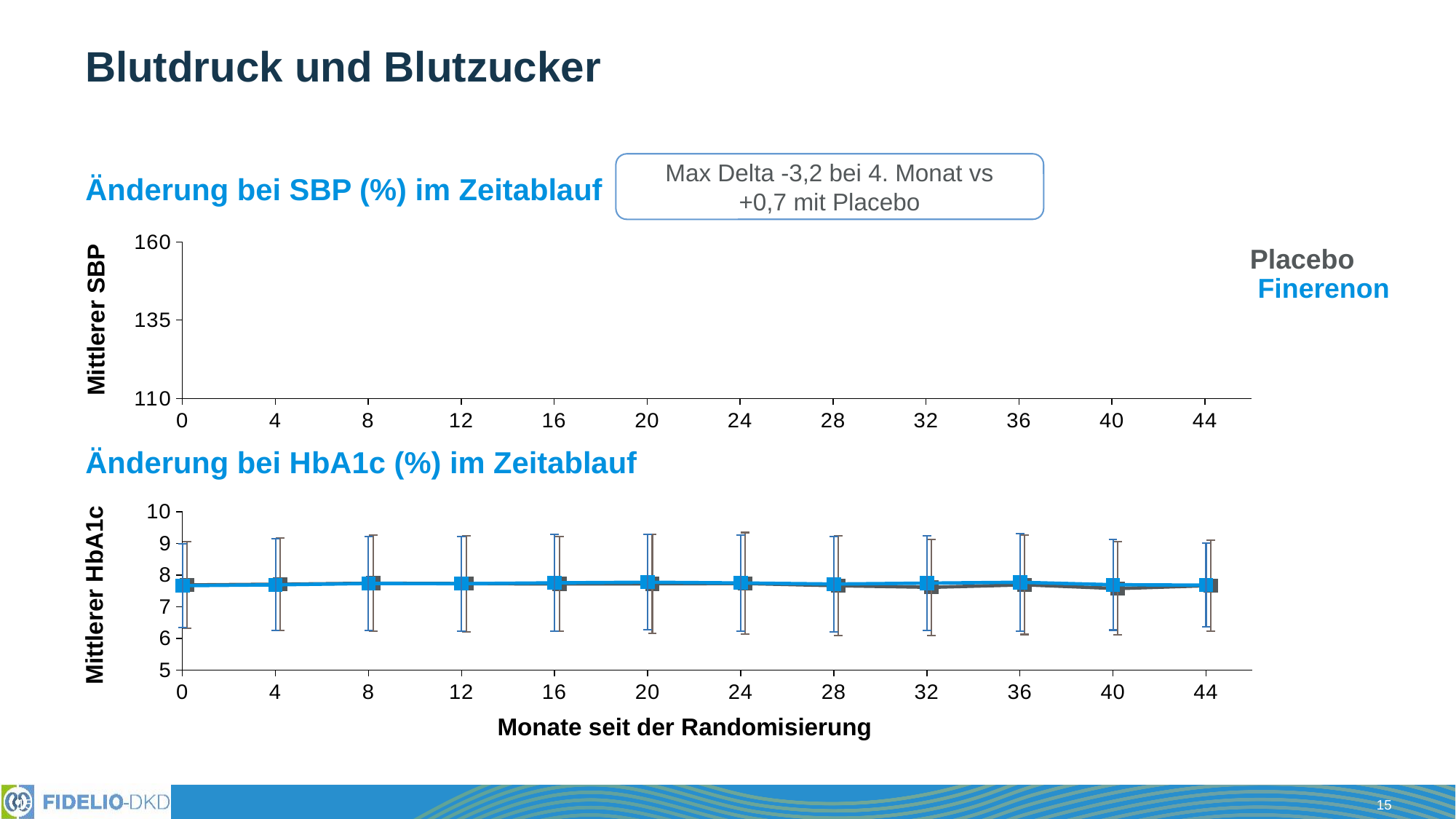
Which series in the HbA1c chart is drawn in blue? Finerenon In the 'Änderung bei HbA1c (%) im Zeitablauf' chart, do the Finerenon values rise, fall or stay roughly flat from month 0 to month 44? stay roughly flat In the HbA1c chart, is the Finerenon value at month 20 greater or less than 6? greater In the HbA1c chart, is the Finerenon value at month 0 greater or less than 7? greater How many time points are plotted along the x axis of the 'Änderung bei HbA1c (%) im Zeitablauf' chart? 12 In the HbA1c chart, is the Placebo value at month 36 greater or less than 9? less What is the x-axis title of the HbA1c chart? Monate seit der Randomisierung What kind of chart is the 'Änderung bei HbA1c (%) im Zeitablauf' chart? line chart